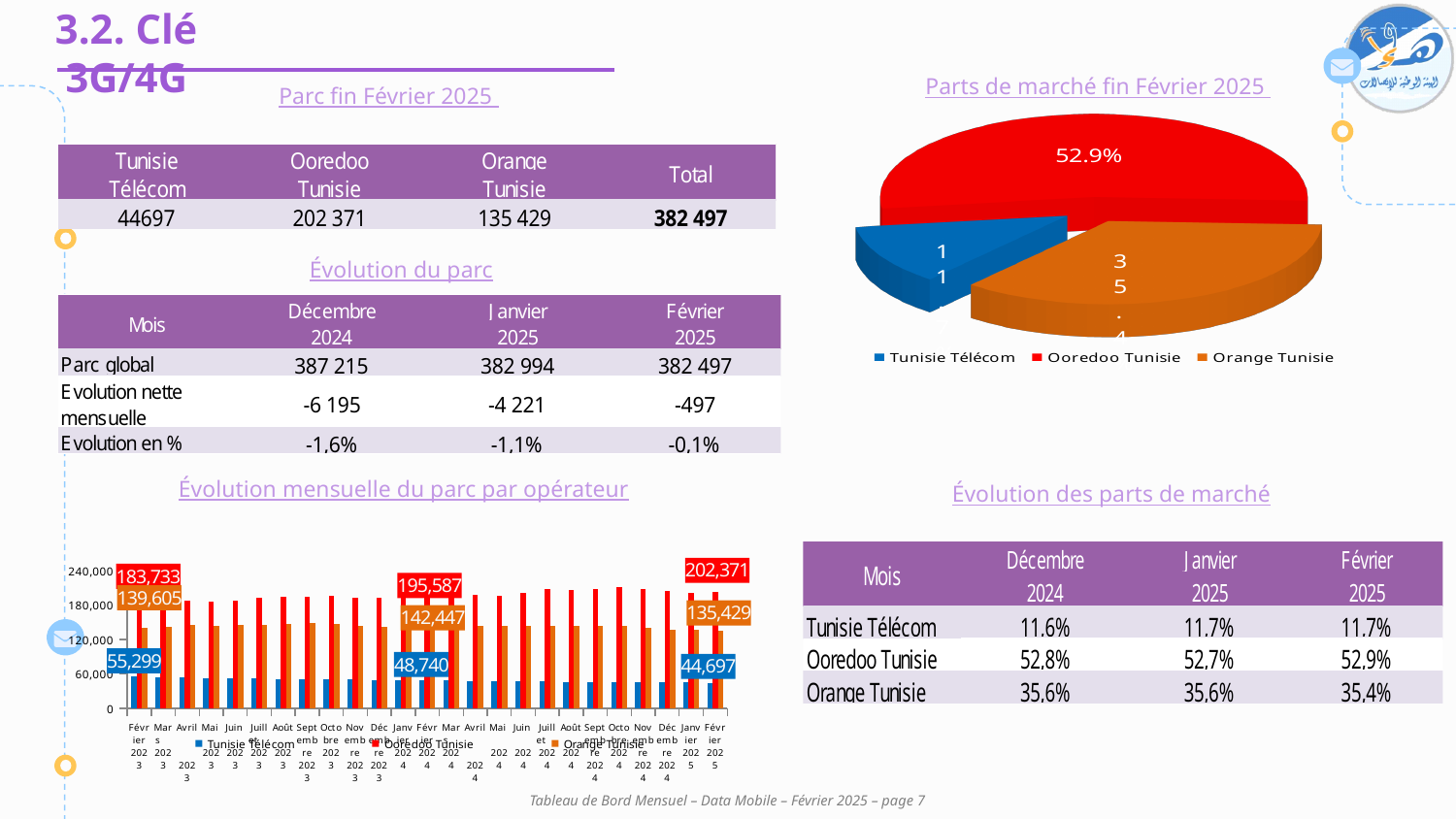
In the 'Parts de marché fin Février 2025' pie chart, what share does Ooredoo Tunisie hold? 52.9% In the 'Parts de marché fin Février 2025' pie chart, which operator has the largest slice? Ooredoo Tunisie In the 'Évolution mensuelle du parc par opérateur' chart, is the Orange Tunisie value higher in Février 2023 or Février 2025? Février 2023 In the 'Évolution mensuelle du parc par opérateur' chart, what is the value for Tunisie Télécom in Février 2023? 55,299 What kind of chart is the 'Évolution mensuelle du parc par opérateur' chart? bar chart What kind of chart is the 'Parts de marché fin Février 2025' chart? pie chart In the 'Évolution mensuelle du parc par opérateur' chart, do the labelled Tunisie Télécom values rise or fall from Février 2023 to Février 2025? fall In the 'Évolution mensuelle du parc par opérateur' chart, what is the difference between the Ooredoo Tunisie values for Février 2025 and Février 2024? 6,784 How many entries does the legend of the 'Parts de marché fin Février 2025' pie chart list? 3 In the 'Évolution mensuelle du parc par opérateur' chart, what is the value for Ooredoo Tunisie in Février 2025? 202,371 In the 'Évolution mensuelle du parc par opérateur' chart, what is the value for Orange Tunisie in Février 2024? 142,447 In the 'Évolution mensuelle du parc par opérateur' chart, is the value for Ooredoo Tunisie in Décembre 2024 greater or less than 180,000? greater